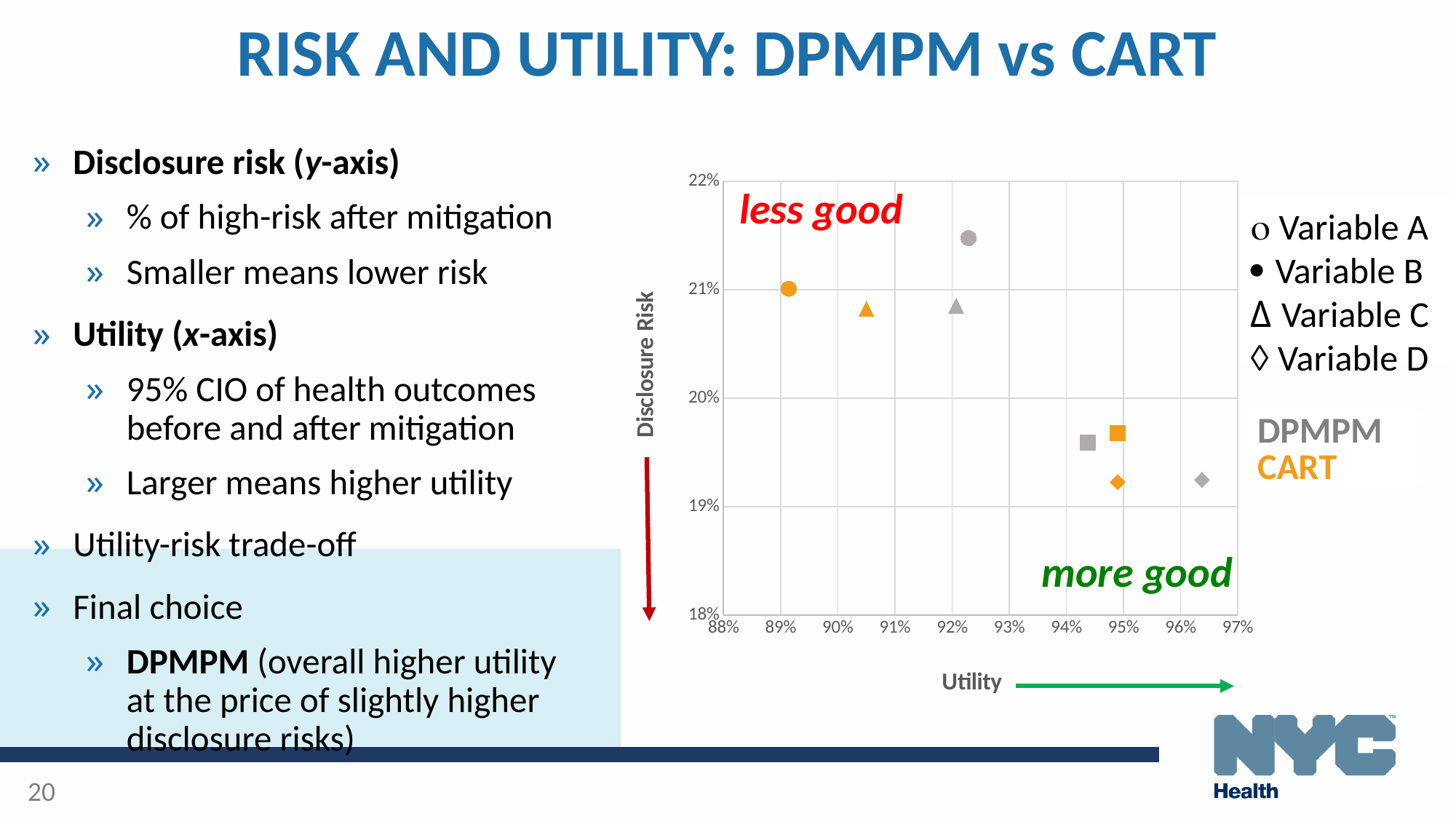
Is the disclosure risk for the CART Variable D point greater or less than 20%? less What is the label of the y-axis of the chart? Disclosure Risk Which point has the highest disclosure risk on the chart? DPMPM Variable A Is the utility for the CART Variable A point greater or less than 90%? less Is the disclosure risk for the DPMPM Variable A point greater or less than 21%? greater How many data points are plotted on the chart? 8 Which colour represents DPMPM on the chart? Gray For Variable A, which method has the higher utility, DPMPM or CART? DPMPM What is the label of the x-axis of the chart? Utility How many variables does the chart's legend list? 4 What kind of chart is shown on the slide? Scatter chart